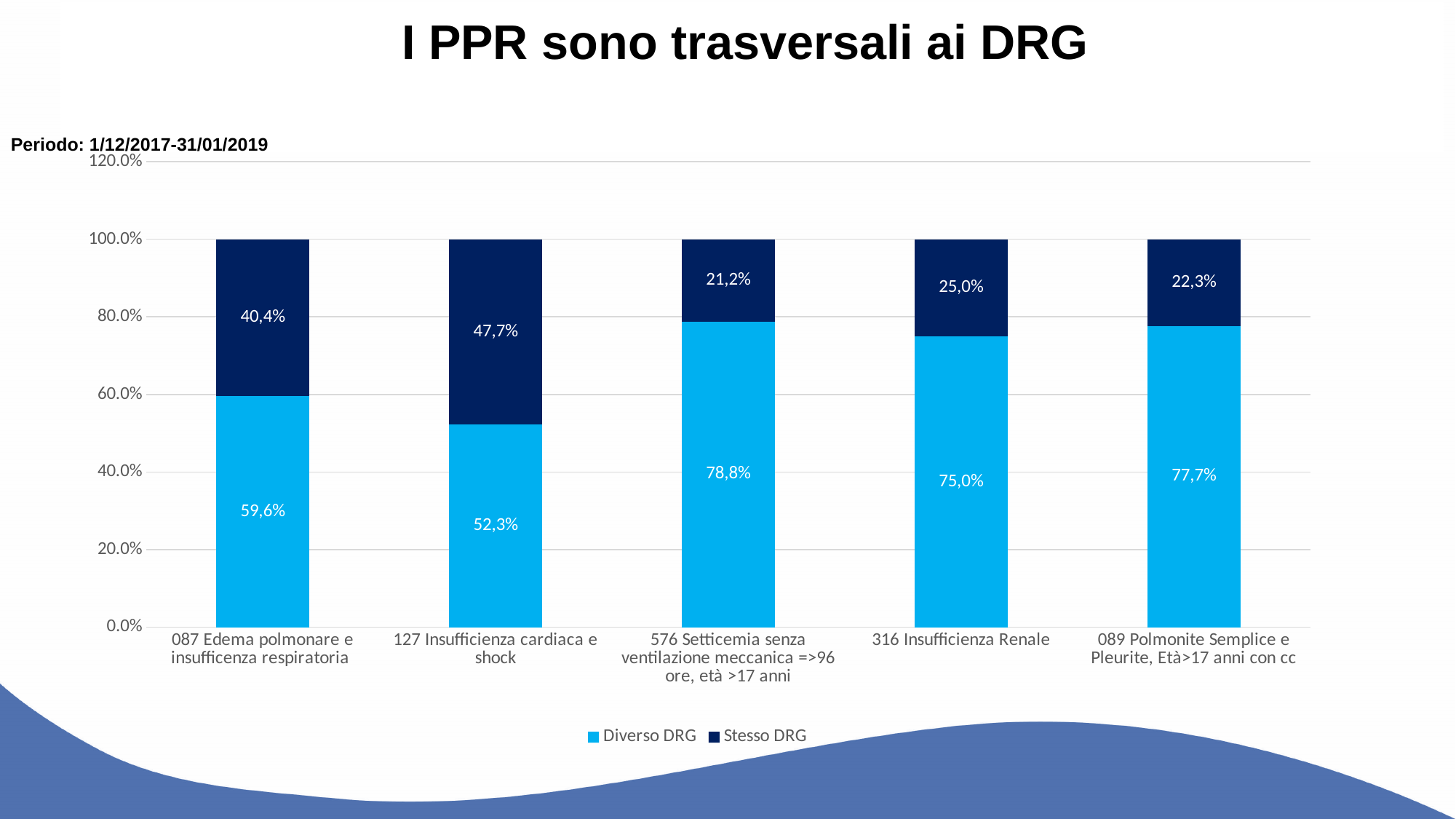
What is the Stesso DRG value for 127 Insufficienza cardiaca e shock? 47,7% Which category has the lowest Stesso DRG value? 576 Setticemia senza ventilazione meccanica =>96 ore, età >17 anni How many DRG categories are shown on the x axis? 5 What is the difference between the Diverso DRG and Stesso DRG values for 087 Edema polmonare e insufficenza respiratoria? 19,2% What kind of chart is shown on the slide? Stacked bar chart How many series does the legend list? 2 What is the Diverso DRG value for 316 Insufficienza Renale? 75,0% What is the Diverso DRG value for 576 Setticemia senza ventilazione meccanica =>96 ore, età >17 anni? 78,8% Is the Diverso DRG value for 127 Insufficienza cardiaca e shock greater or less than 60.0%? less Which is larger: the Stesso DRG value for 316 Insufficienza Renale or for 089 Polmonite Semplice e Pleurite, Età>17 anni con cc? 316 Insufficienza Renale What period is stated above the chart? 1/12/2017-31/01/2019 Which category has the highest Diverso DRG value? 576 Setticemia senza ventilazione meccanica =>96 ore, età >17 anni